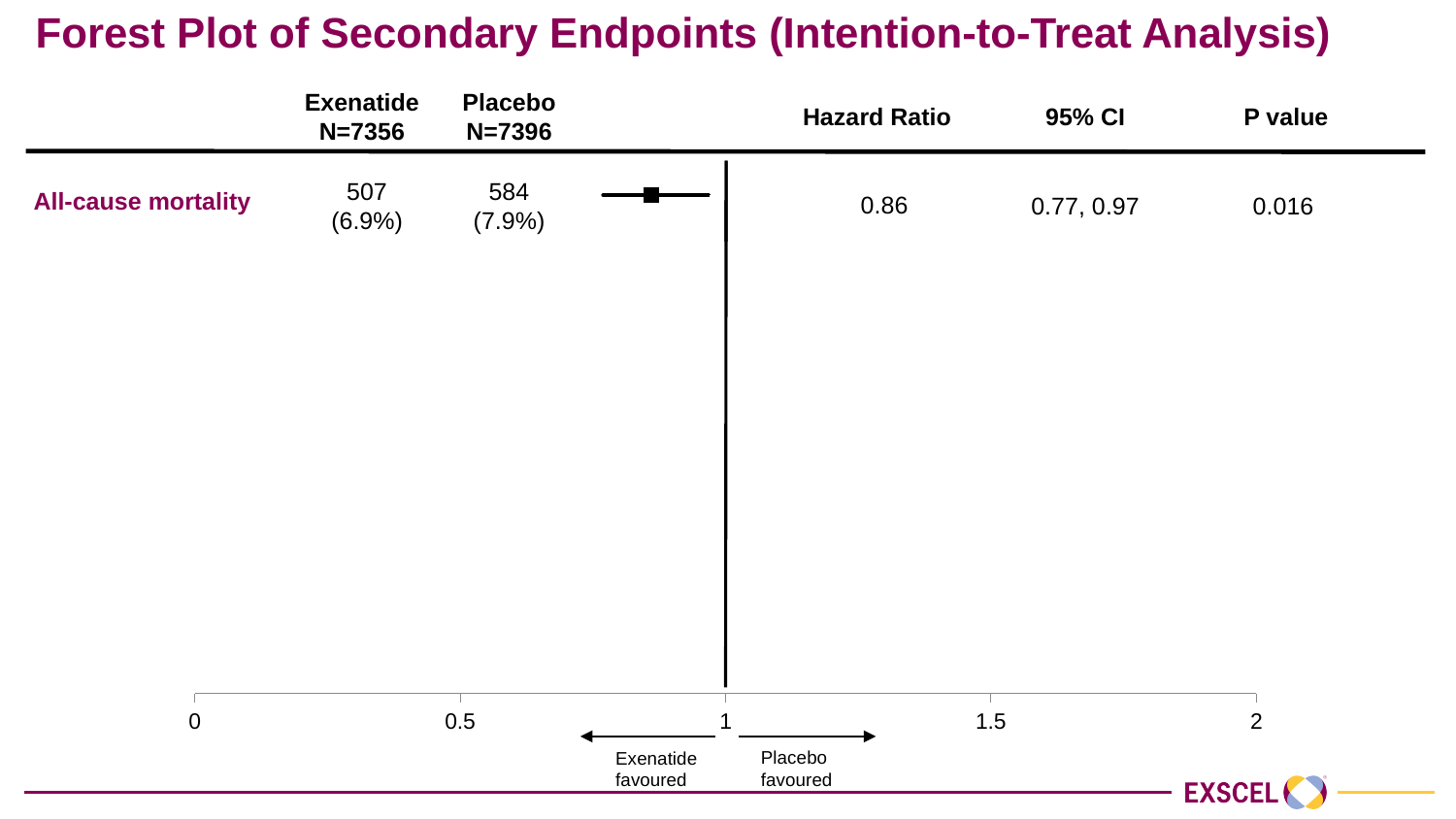
What percentage of the Exenatide group experienced all-cause mortality? 6.9% What is the N for the Exenatide group shown in the column header? 7356 What is the hazard ratio for all-cause mortality? 0.86 How many all-cause mortality events occurred in the Placebo group? 584 What is the P value for all-cause mortality? 0.016 What percentage of the Placebo group experienced all-cause mortality? 7.9% How many endpoints are plotted on the forest plot? 1 What is the difference in the number of all-cause mortality events between the Placebo and Exenatide groups? 77 How many all-cause mortality events occurred in the Exenatide group? 507 Is the hazard ratio point estimate for all-cause mortality greater or less than 1? less Which group had more all-cause mortality events, Exenatide or Placebo? Placebo What is the 95% CI for all-cause mortality? 0.77, 0.97